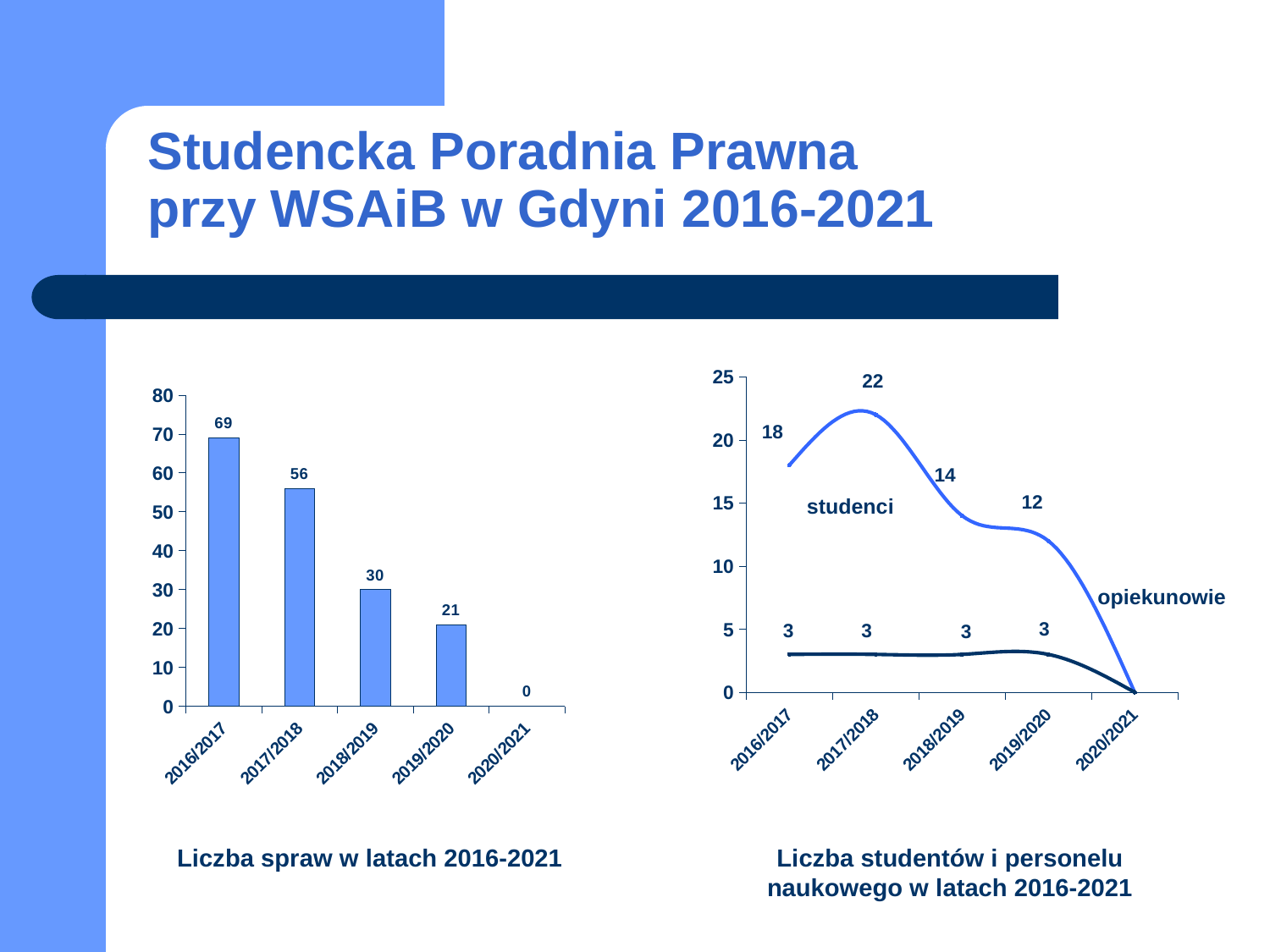
In the chart 'Liczba studentów i personelu naukowego w latach 2016-2021', what is the value for opiekunowie in 2019/2020? 3 In the chart 'Liczba studentów i personelu naukowego w latach 2016-2021', what is the difference between studenci and opiekunowie in 2016/2017? 15 What kind of chart is 'Liczba spraw w latach 2016-2021'? bar chart In the chart 'Liczba studentów i personelu naukowego w latach 2016-2021', what is the value for studenci in 2017/2018? 22 In the chart 'Liczba spraw w latach 2016-2021', which year has the highest value? 2016/2017 In the chart 'Liczba studentów i personelu naukowego w latach 2016-2021', which is larger in 2018/2019: studenci or opiekunowie? studenci In the chart 'Liczba spraw w latach 2016-2021', how many years are shown on the x axis? 5 In the chart 'Liczba spraw w latach 2016-2021', what is the difference between the values for 2016/2017 and 2018/2019? 39 In the chart 'Liczba spraw w latach 2016-2021', what is the value for 2017/2018? 56 What kind of chart is 'Liczba studentów i personelu naukowego w latach 2016-2021'? line chart In the chart 'Liczba spraw w latach 2016-2021', which year has the lowest value? 2020/2021 In the chart 'Liczba spraw w latach 2016-2021', do the values rise or fall from 2016/2017 to 2020/2021? fall